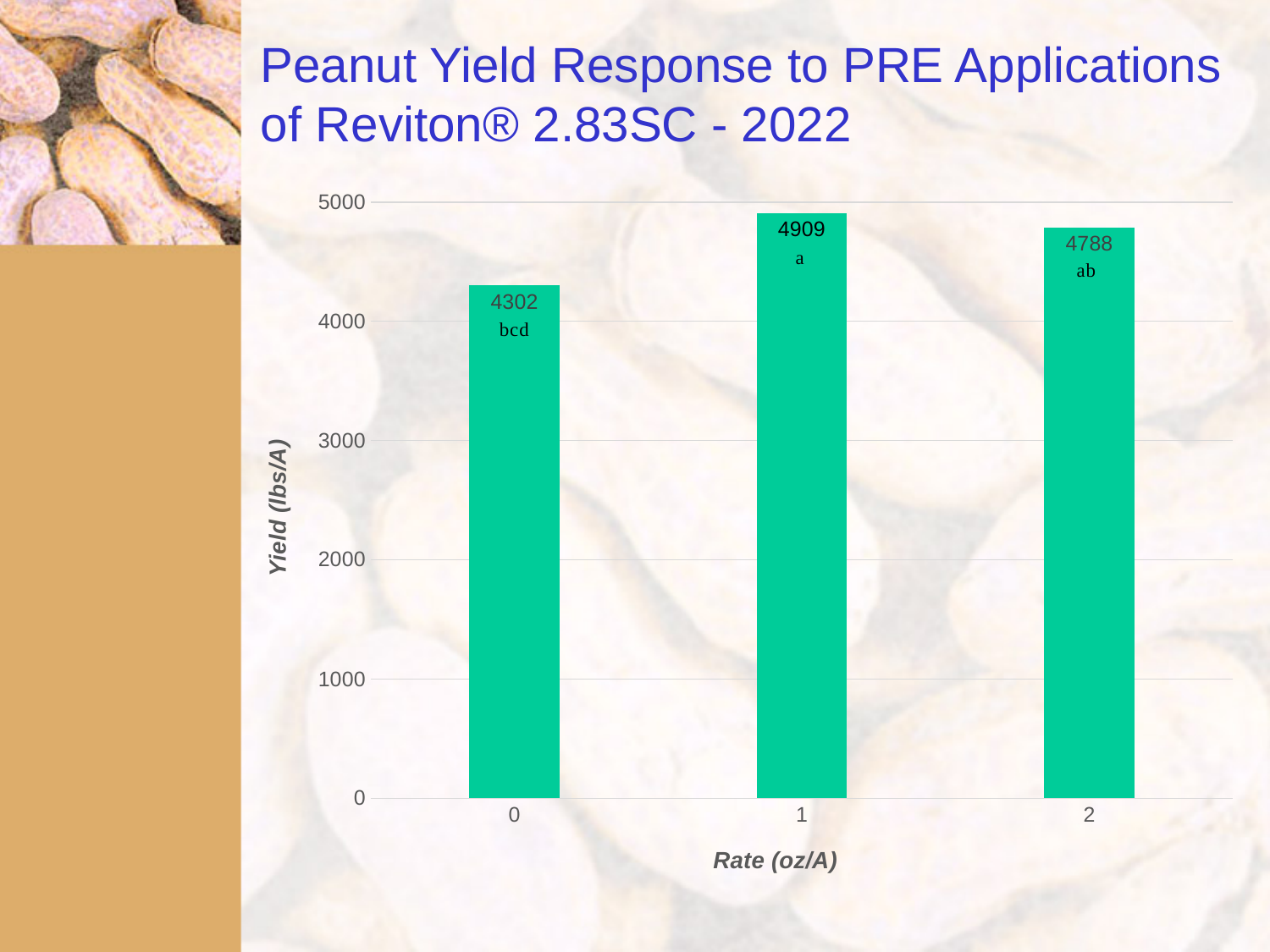
What is the difference in yield between the 1 oz/A rate and the 2 oz/A rate? 121 How many rate categories are shown on the x axis? 3 Which rate (oz/A) gives the highest yield? 1 What is the yield (lbs/A) at a rate of 0 oz/A? 4302 What is the yield (lbs/A) at a rate of 1 oz/A? 4909 What is the difference in yield between the 1 oz/A rate and the 0 oz/A rate? 607 Which has a higher yield, the 0 oz/A rate or the 2 oz/A rate? 2 oz/A What is the label of the y axis? Yield (lbs/A) Is the yield at the 0 oz/A rate greater or less than 4000? greater What is the yield (lbs/A) at a rate of 2 oz/A? 4788 Which rate (oz/A) gives the lowest yield? 0 What kind of chart is shown on the slide? bar chart